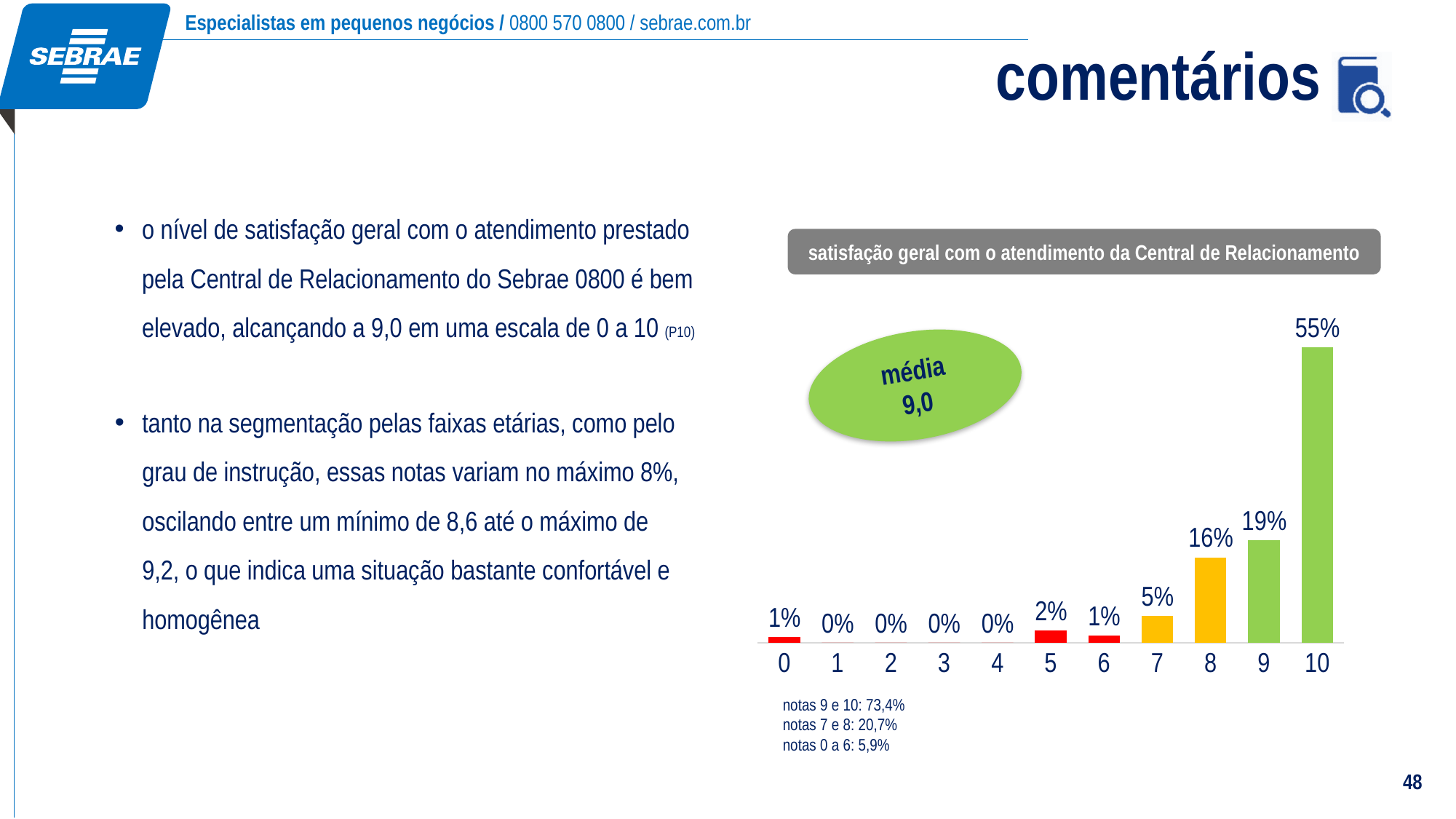
What percentage of respondents gave a score of 5? 2% Do the percentages generally rise or fall as the score increases from 6 to 10? Rise What average score (média) is shown in the green oval on the chart? 9,0 How many score categories are shown on the x axis? 11 Which score has the highest percentage of respondents? 10 What type of chart is shown on the slide? Bar chart What is the difference in percentage points between scores 10 and 9? 36 What percentage of respondents gave a score of 10? 55% What is the difference in percentage points between scores 9 and 8? 3 What percentage of respondents gave a score of 8? 16% What percentage of respondents gave a score of 7? 5% Which has a larger percentage, score 7 or score 6? Score 7